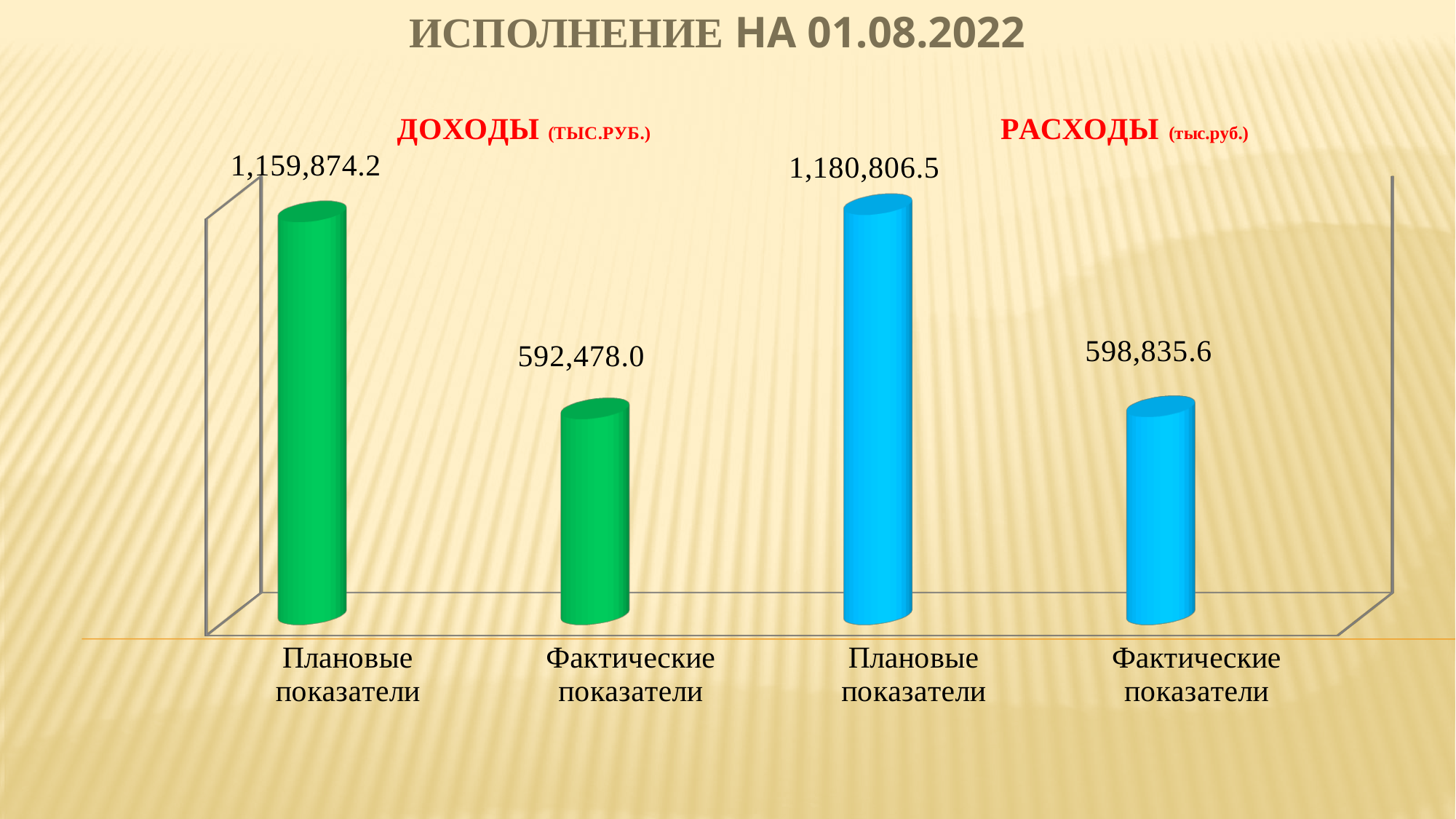
What is the title of the slide? ИСПОЛНЕНИЕ НА 01.08.2022 How many bars are plotted on the chart? 4 What is the difference between Плановые показатели and Фактические показатели for РАСХОДЫ? 581,970.9 What kind of chart is shown on the slide? Bar chart Which bar has the highest value on the chart? Плановые показатели (РАСХОДЫ) What is the difference between Плановые показатели and Фактические показатели for ДОХОДЫ? 567,396.2 Which is larger: Плановые показатели for ДОХОДЫ or Плановые показатели for РАСХОДЫ? Плановые показатели for РАСХОДЫ What is the value of Плановые показатели for РАСХОДЫ? 1,180,806.5 What is the value of Фактические показатели for ДОХОДЫ? 592,478.0 What is the value of Фактические показатели for РАСХОДЫ? 598,835.6 Which bar has the lowest value on the chart? Фактические показатели (ДОХОДЫ) What is the value of Плановые показатели for ДОХОДЫ? 1,159,874.2